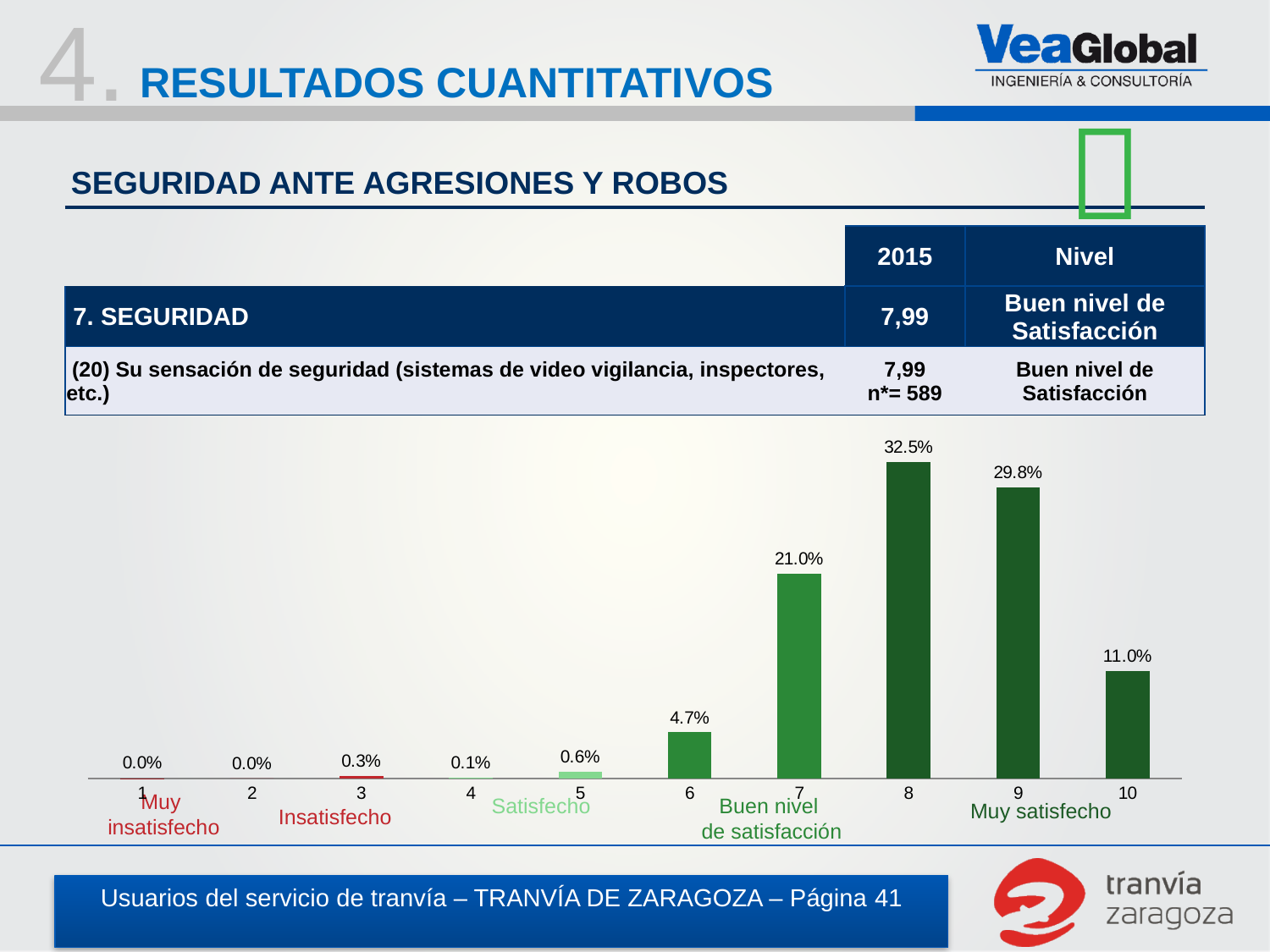
What kind of chart is shown on the slide? bar chart What is the value for category 6 in the bar chart? 4.7% Which category has the highest value in the bar chart? 8 What is the value for category 10 in the bar chart? 11.0% What is the value for category 5 in the bar chart? 0.6% Which is larger, the value for category 9 or the value for category 10? 9 What is the difference between the values for categories 7 and 10? 10.0% What is the value for category 7 in the bar chart? 21.0% What is the value for category 3 in the bar chart? 0.3% What is the value for category 8 in the bar chart? 32.5% How many categories are plotted in the bar chart? 10 What is the difference between the values for categories 8 and 9? 2.7%